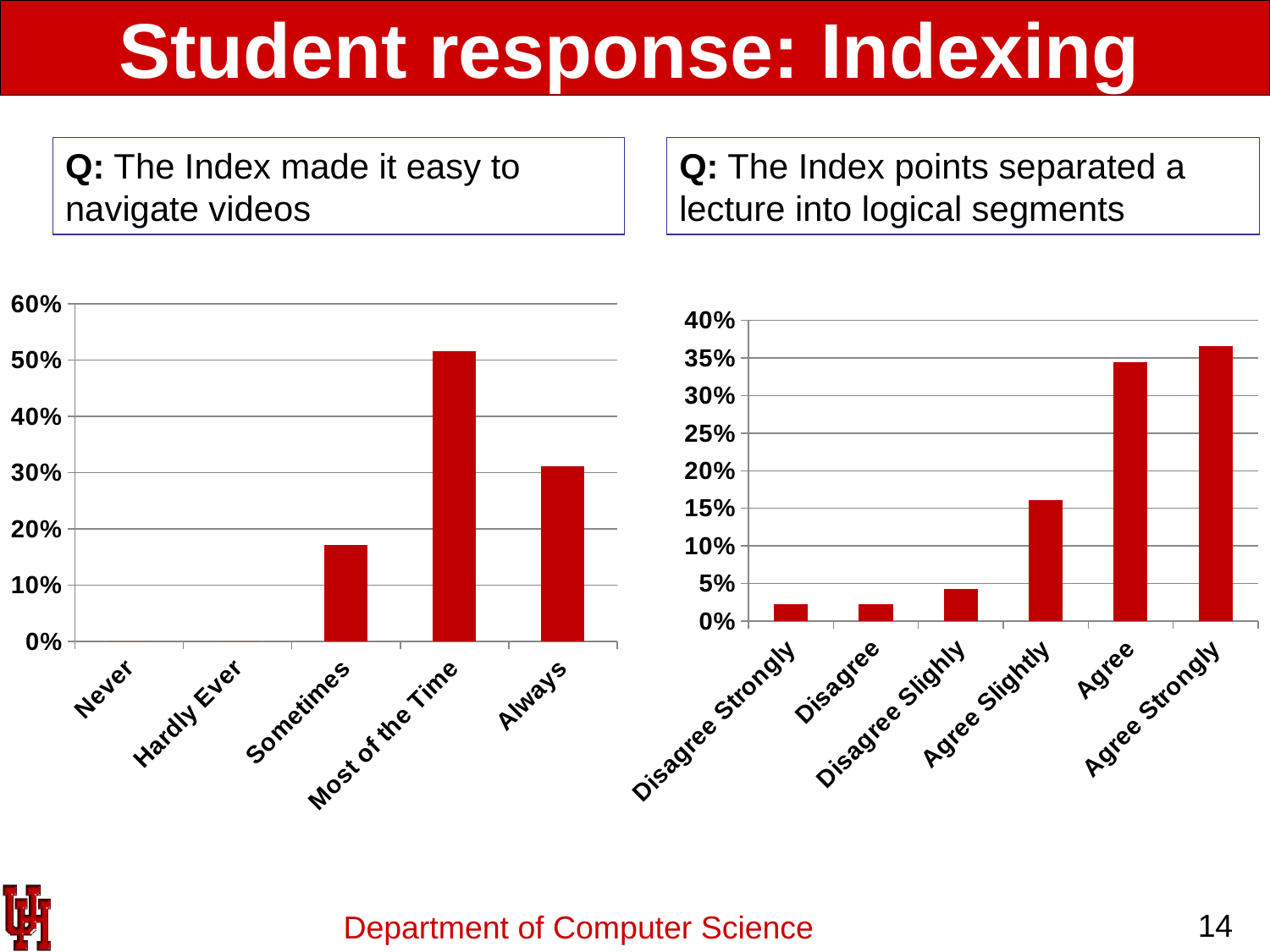
How many response categories are shown on the x axis of the right chart ("The Index points separated a lecture into logical segments")? 6 In the right chart ("The Index points separated a lecture into logical segments"), is the value for Agree greater or less than 30%? greater How many response categories are shown on the x axis of the left chart ("The Index made it easy to navigate videos")? 5 What kind of chart is the left chart ("The Index made it easy to navigate videos")? bar chart In the left chart ("The Index made it easy to navigate videos"), which is larger, the value for Always or the value for Sometimes? Always In the left chart ("The Index made it easy to navigate videos"), is the value for Sometimes greater or less than 20%? less In the left chart ("The Index made it easy to navigate videos"), is the value for Most of the Time greater or less than 40%? greater In the right chart ("The Index points separated a lecture into logical segments"), do the values generally rise or fall from Disagree Strongly to Agree Strongly? rise In the right chart ("The Index points separated a lecture into logical segments"), which category has the highest value? Agree Strongly In the left chart ("The Index made it easy to navigate videos"), which category has the highest value? Most of the Time What is the highest value shown on the y axis of the right chart ("The Index points separated a lecture into logical segments")? 40%